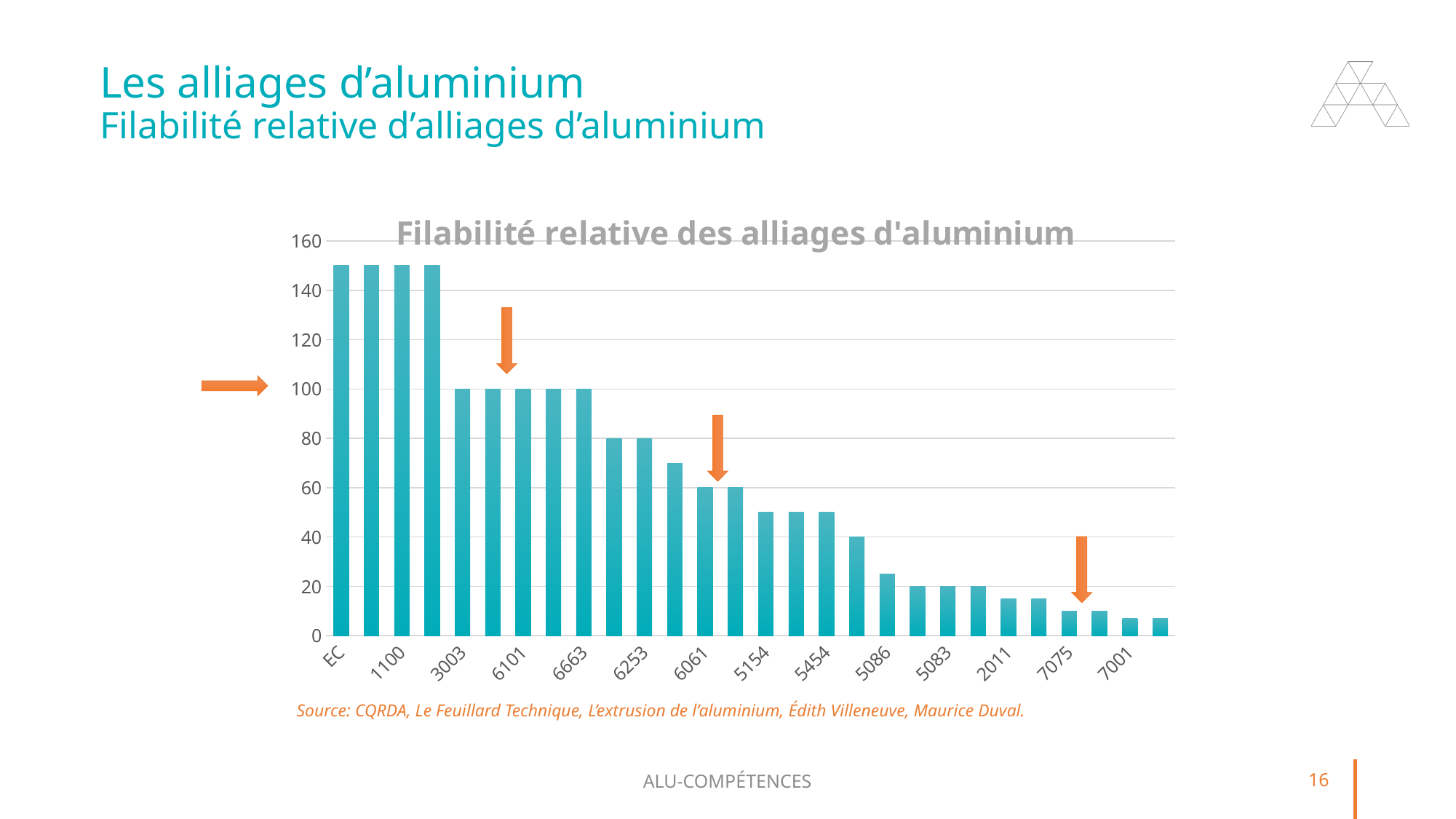
What type of chart is shown on the slide? bar chart Do the values rise or fall from left to right along the x axis? fall What is the value for alloy 6253? 80 What is the value for alloy 5083? 20 What is the value for alloy 3003? 100 Is the value for alloy 7075 greater or less than 20? less Which has a higher value, alloy 6101 or alloy 5154? 6101 What is the title of the chart? Filabilité relative des alliages d'aluminium Is the value for alloy 5086 greater or less than 20? greater What is the difference between the values for alloy 6663 and alloy 6253? 20 What is the value for alloy 6061? 60 Is the value for EC greater or less than 140? greater